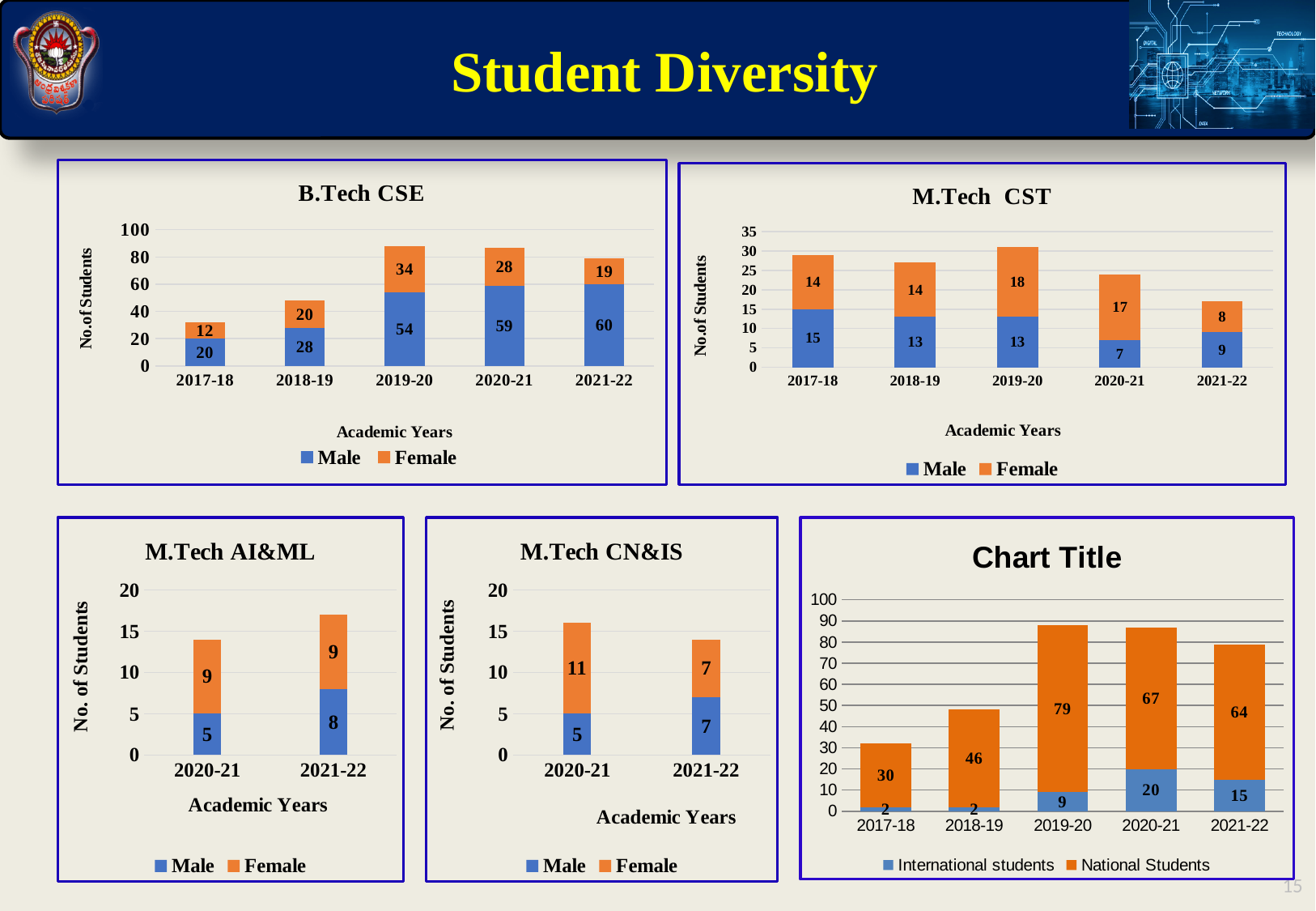
In the M.Tech CN&IS chart, how many academic years are shown on the x axis? 2 In the M.Tech CST chart, what is the difference between female and male students in 2019-20? 5 In the B.Tech CSE chart, what is the total height of the stacked bar for 2017-18? 32 What type of chart is the M.Tech AI&ML chart? Stacked bar chart In the B.Tech CSE chart, how many male students were there in 2019-20? 54 In the M.Tech CST chart, how many female students were there in 2020-21? 17 In the M.Tech CST chart, which academic year has the lowest number of male students? 2020-21 In the B.Tech CSE chart, which academic year has the highest number of female students? 2019-20 In the chart titled 'Chart Title', how many national students were there in 2019-20? 79 In the M.Tech CN&IS chart, what is the total number of students in 2020-21? 16 In the M.Tech AI&ML chart, how many male students were there in 2021-22? 8 In the chart titled 'Chart Title', which is larger: international students in 2020-21 or international students in 2021-22? 2020-21